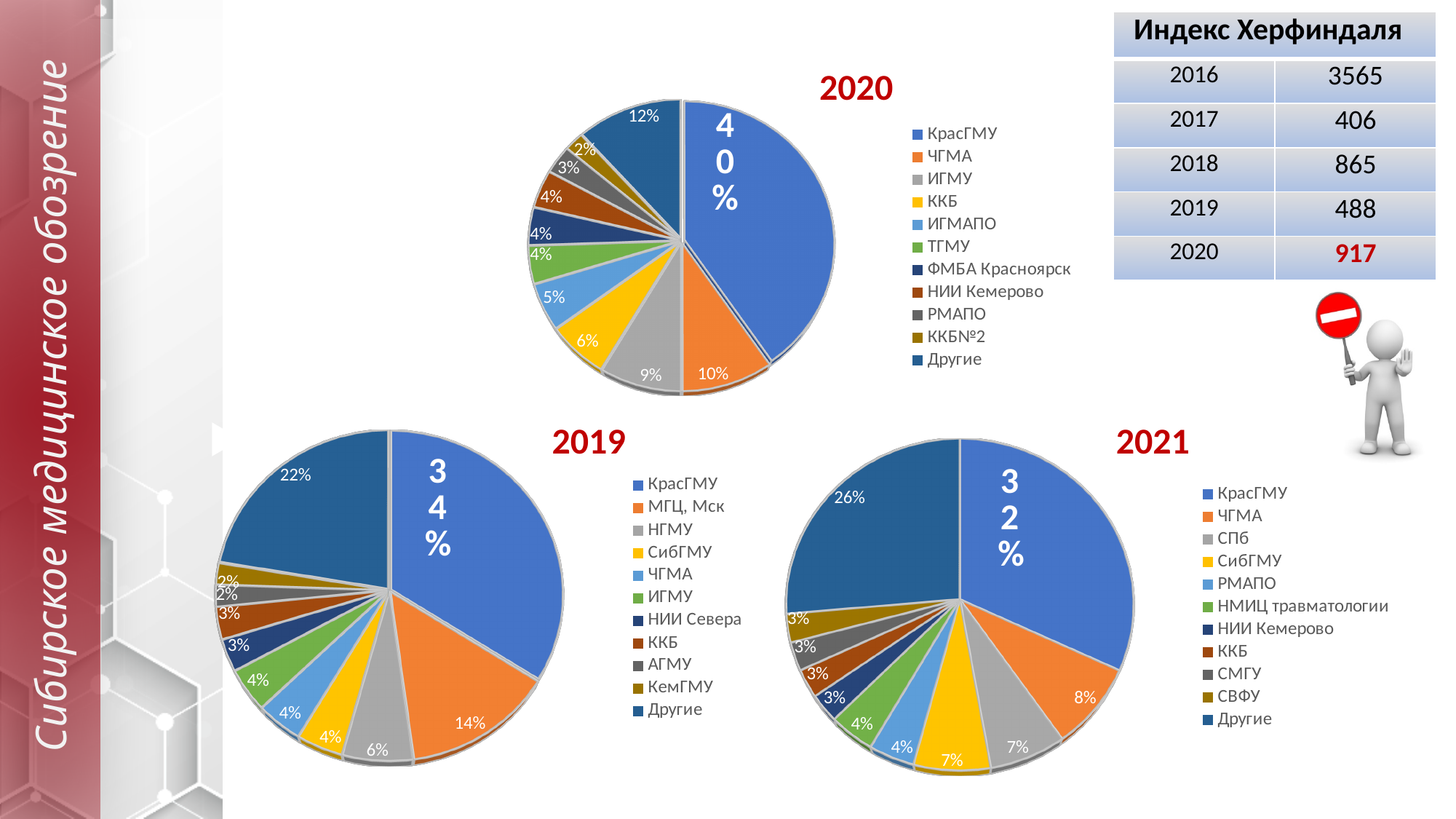
In the 2021 pie chart, what share does Другие have? 26% In the 2019 pie chart, which category has the largest slice? КрасГМУ In the 2019 pie chart, what share does МГЦ, Мск have? 14% How many entries does the legend of the 2021 pie chart list? 11 In the 2020 pie chart, what is the difference between the КрасГМУ share and the Другие share? 28% In the 2019 pie chart, what share does Другие have? 22% In the 2020 pie chart, which category has the largest slice? КрасГМУ In the 2021 pie chart, what is the difference between the КрасГМУ share and the Другие share? 6% In the 2021 pie chart, which is larger, the ЧГМА slice or the СПб slice? ЧГМА What type of chart is used for the 2019 data? Pie chart